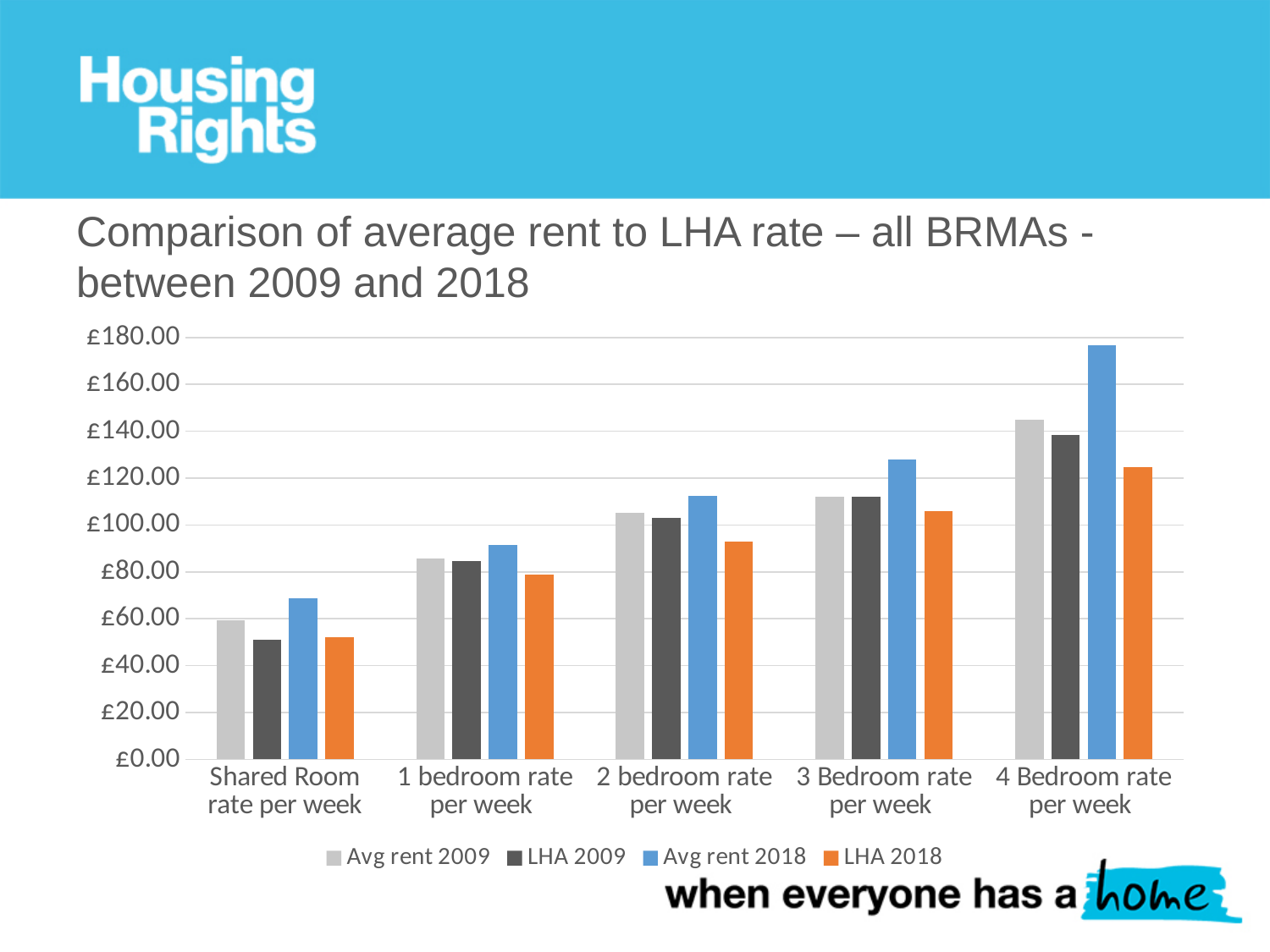
Do the Avg rent 2018 values rise or fall moving from Shared Room rate per week to 4 Bedroom rate per week? rise For 4 Bedroom rate per week, which is larger: Avg rent 2018 or LHA 2018? Avg rent 2018 Is the Avg rent 2018 value for 3 Bedroom rate per week greater or less than £120.00? greater Which category has the highest Avg rent 2018 value? 4 Bedroom rate per week Is the LHA 2018 value for Shared Room rate per week greater or less than £60.00? less Is the LHA 2018 value for 2 bedroom rate per week greater or less than £100.00? less How many series does the legend list? 4 How many categories are shown on the x axis? 5 Which category has the lowest LHA 2009 value? Shared Room rate per week What colour represents the LHA 2018 series in the legend? Orange What kind of chart is shown on the slide? Bar chart